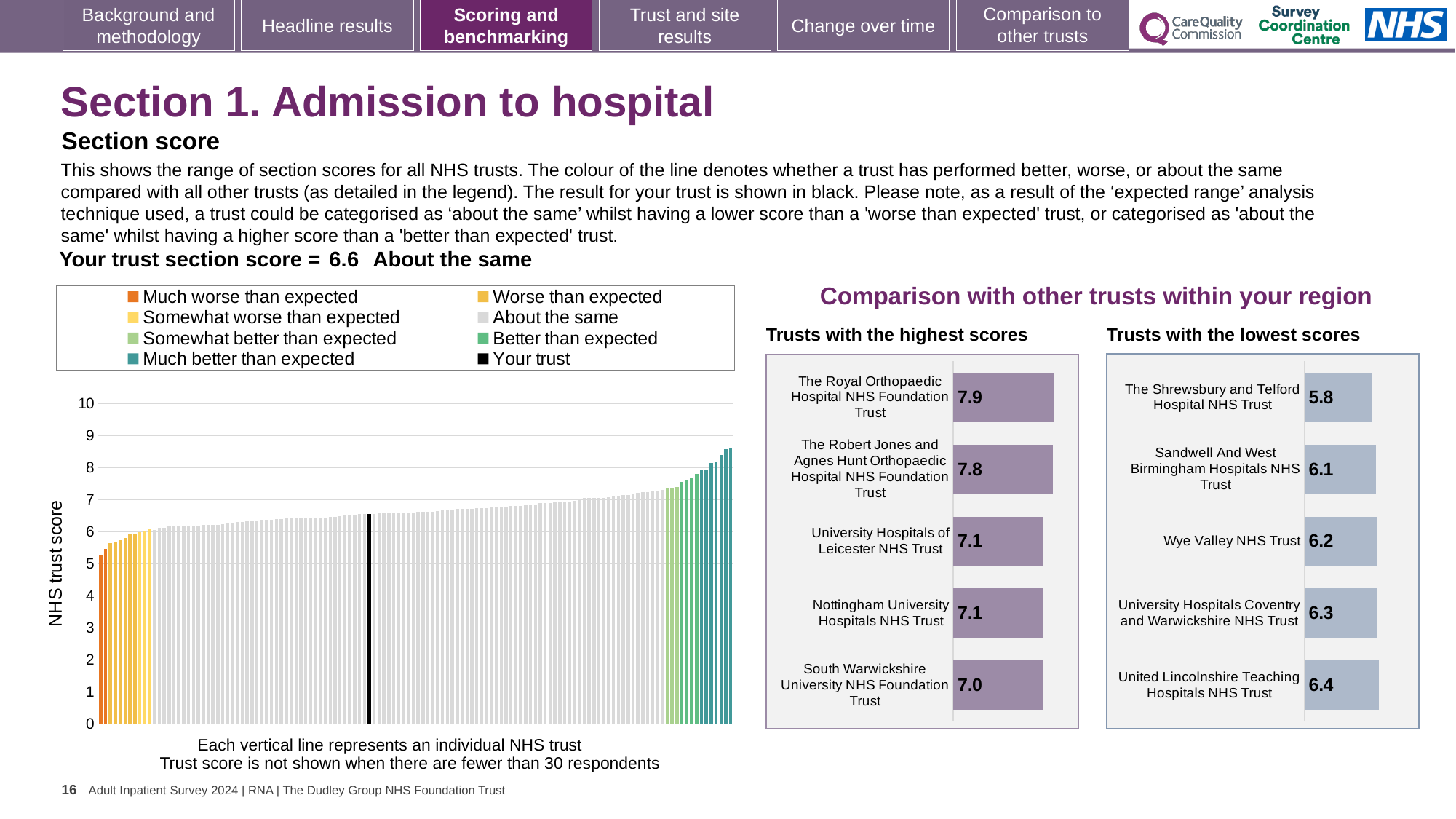
In the 'Trusts with the highest scores' chart, which trust has the highest score? The Royal Orthopaedic Hospital NHS Foundation Trust In the 'Trusts with the highest scores' chart, what is the difference between the scores of The Royal Orthopaedic Hospital NHS Foundation Trust and South Warwickshire University NHS Foundation Trust? 0.9 In the 'Trusts with the lowest scores' chart, which has the larger score: Sandwell And West Birmingham Hospitals NHS Trust or Wye Valley NHS Trust? Wye Valley NHS Trust In the 'Trusts with the lowest scores' chart, which trust has the lowest score? The Shrewsbury and Telford Hospital NHS Trust How many trusts are shown in the 'Trusts with the highest scores' chart? 5 How many entries does the legend of the NHS trust score chart on the left list? 8 In the 'Trusts with the lowest scores' chart, what is the difference between the scores of United Lincolnshire Teaching Hospitals NHS Trust and The Shrewsbury and Telford Hospital NHS Trust? 0.6 In the NHS trust score chart on the left, do the values rise or fall from left to right? Rise What kind of chart is the NHS trust score chart on the left of the slide? Bar chart In the 'Trusts with the highest scores' chart, what is the score for The Royal Orthopaedic Hospital NHS Foundation Trust? 7.9 In the 'Trusts with the lowest scores' chart, what is the score for Wye Valley NHS Trust? 6.2 In the NHS trust score chart on the left, is the value for the black 'Your trust' bar greater or less than 5? greater